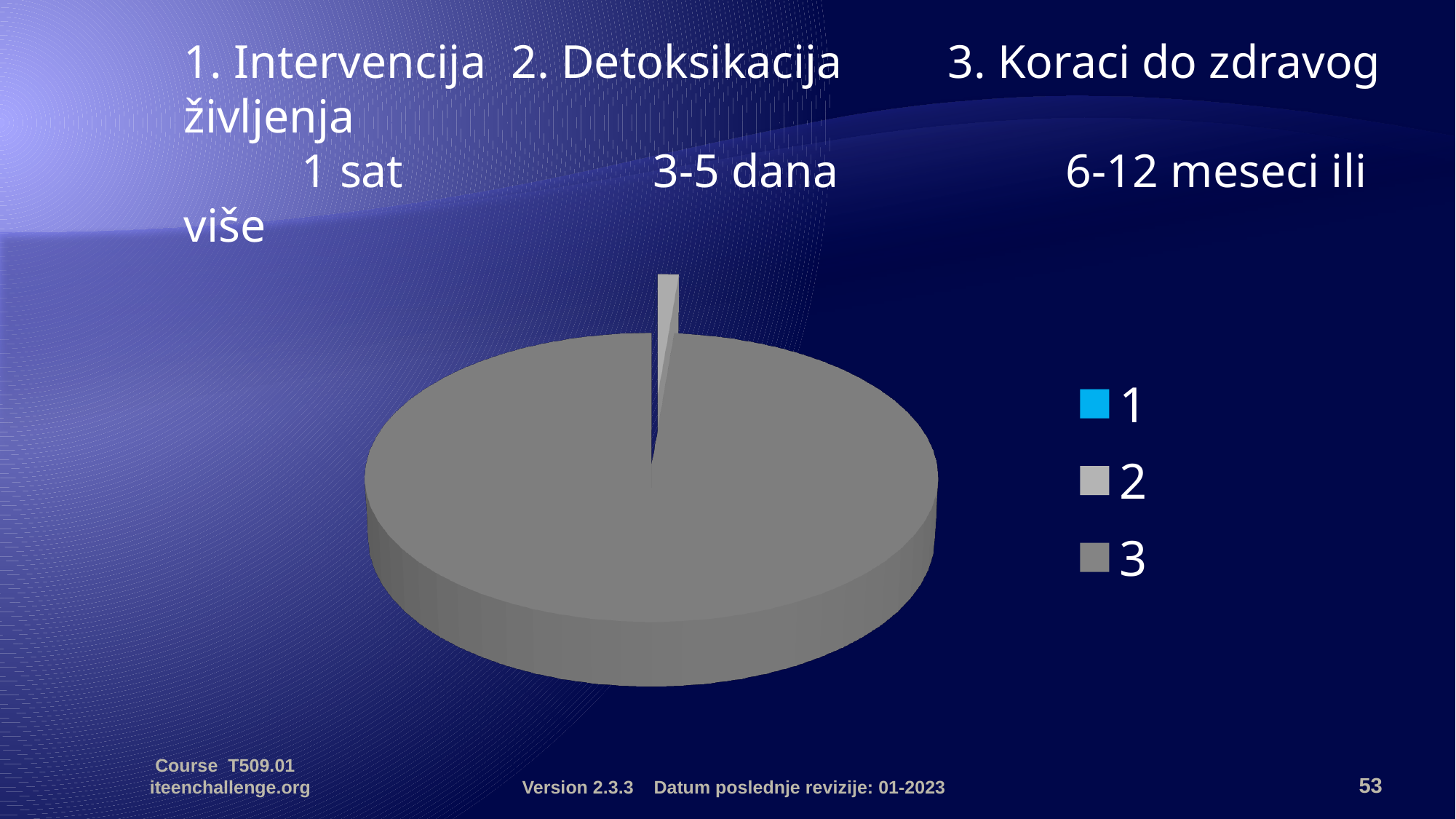
Is the slice for category 2 greater or less than a quarter of the pie? less What colour is the largest slice of the pie? gray What colour does the legend use for category 1? blue Which legend category has the largest slice of the pie? 3 What kind of chart is shown on the slide? pie chart Which slice is larger, category 2 or category 3? 3 Is the slice for category 3 greater or less than half of the pie? greater How many entries does the chart's legend list? 3